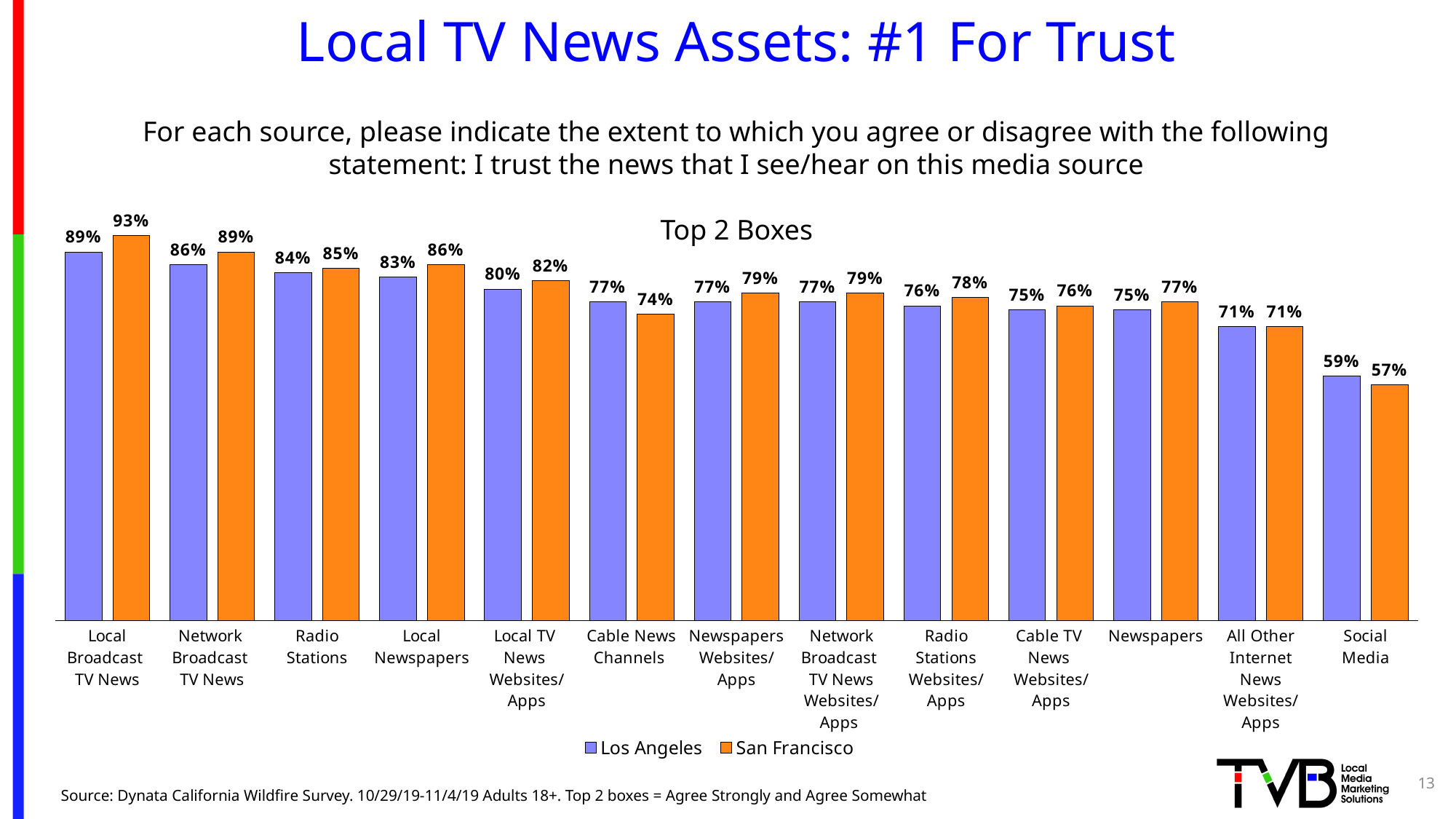
Which is larger for Cable News Channels, the Los Angeles value or the San Francisco value? Los Angeles How many series does the legend list? 2 What is the difference between the San Francisco and Los Angeles values for Local Broadcast TV News? 4% What colour are the San Francisco bars? orange What is the Los Angeles value for Local Broadcast TV News? 89% What kind of chart is shown on the slide? bar chart How many categories are shown on the x axis? 13 Which category has the lowest Los Angeles value? Social Media What is the Los Angeles value for All Other Internet News Websites/Apps? 71% What is the San Francisco value for Cable News Channels? 74% Which category has the highest San Francisco value? Local Broadcast TV News What is the San Francisco value for Social Media? 57%